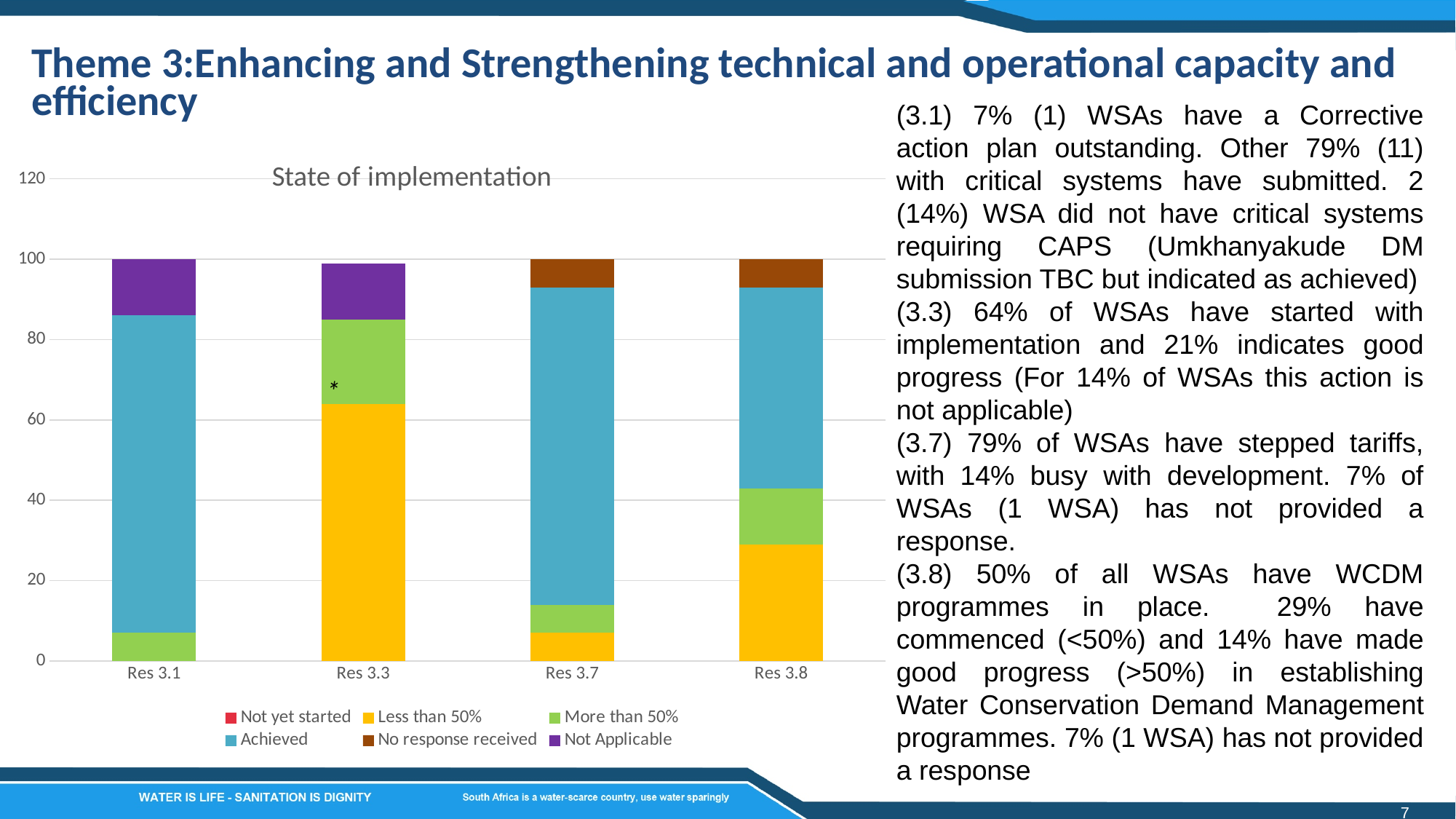
What is the title of the chart? State of implementation In the Res 3.7 bar, is the top of the 'More than 50%' segment greater or less than 20? less In the Res 3.8 bar, is the top of the 'Less than 50%' segment greater or less than 20? greater How many categories are shown on the x axis of the chart? 4 How many series does the chart legend list? 6 Which bar has the larger 'Less than 50%' segment, Res 3.3 or Res 3.8? Res 3.3 In the Res 3.1 bar, is the top of the 'Achieved' segment greater or less than 80? greater What kind of chart is shown on the slide? Stacked bar chart Which category is shown furthest to the right on the x axis? Res 3.8 Which bar has the larger 'Achieved' segment, Res 3.1 or Res 3.8? Res 3.1